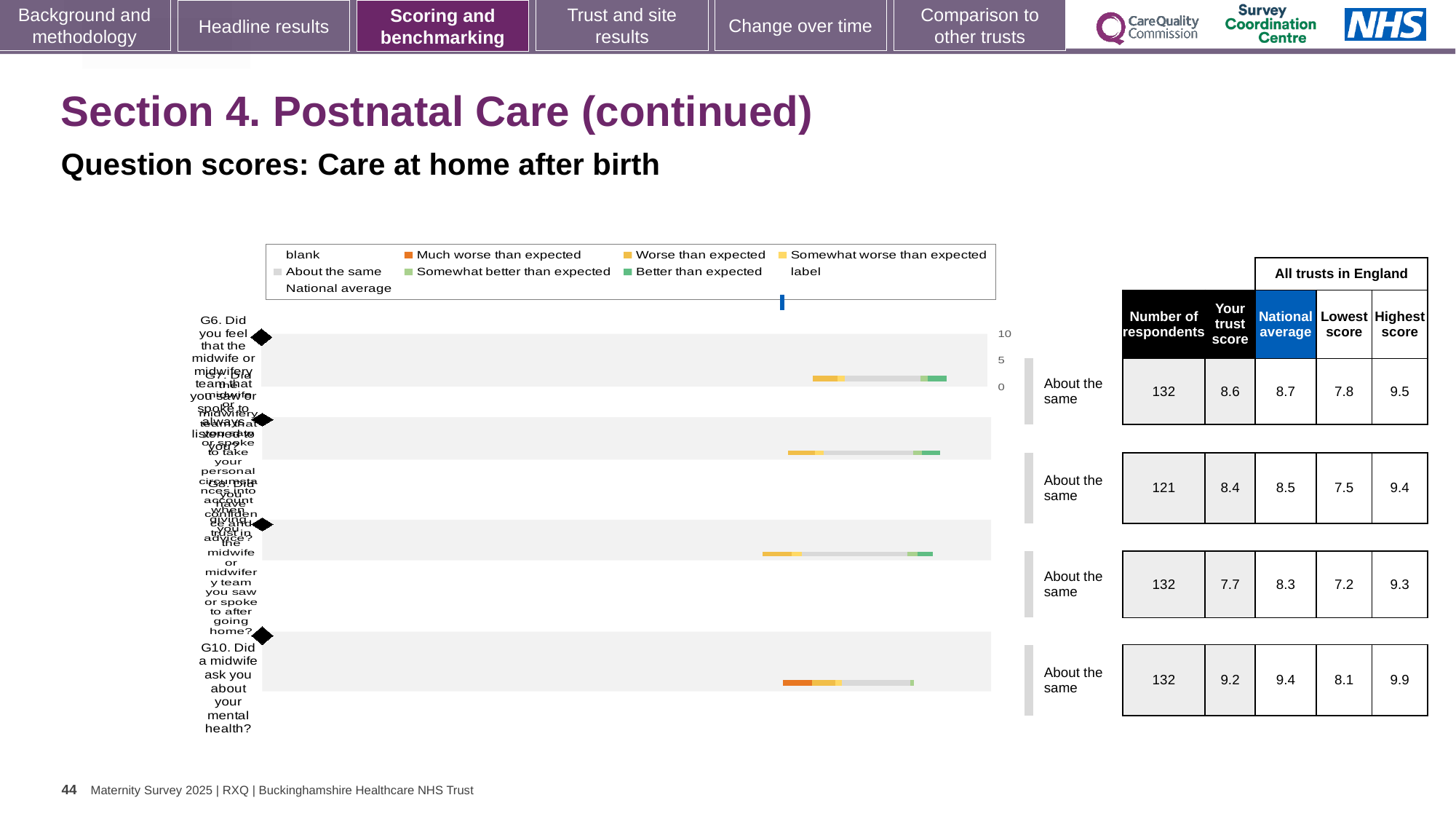
What type of chart is shown on the slide? bar chart What benchmark category is shown for every question in the chart? About the same What is the national average for G10 (Did a midwife ask you about your mental health?)? 9.4 For G10 (Did a midwife ask you about your mental health?), which is larger: the trust score or the national average? national average What is the number of respondents for the second question row in the table? 121 What is the highest score among all trusts in England for G10 (Did a midwife ask you about your mental health?)? 9.9 How many questions (bars) are plotted in the chart? 4 Which colour in the legend represents 'Much worse than expected'? orange What is the 'Your trust score' for G10 (Did a midwife ask you about your mental health?)? 9.2 How many respondents are listed for G10 (Did a midwife ask you about your mental health?)? 132 What is the difference between the national average and the trust score for G10 (Did a midwife ask you about your mental health?)? 0.2 Which question row has the lowest 'Your trust score' in the table? the third row (7.7)